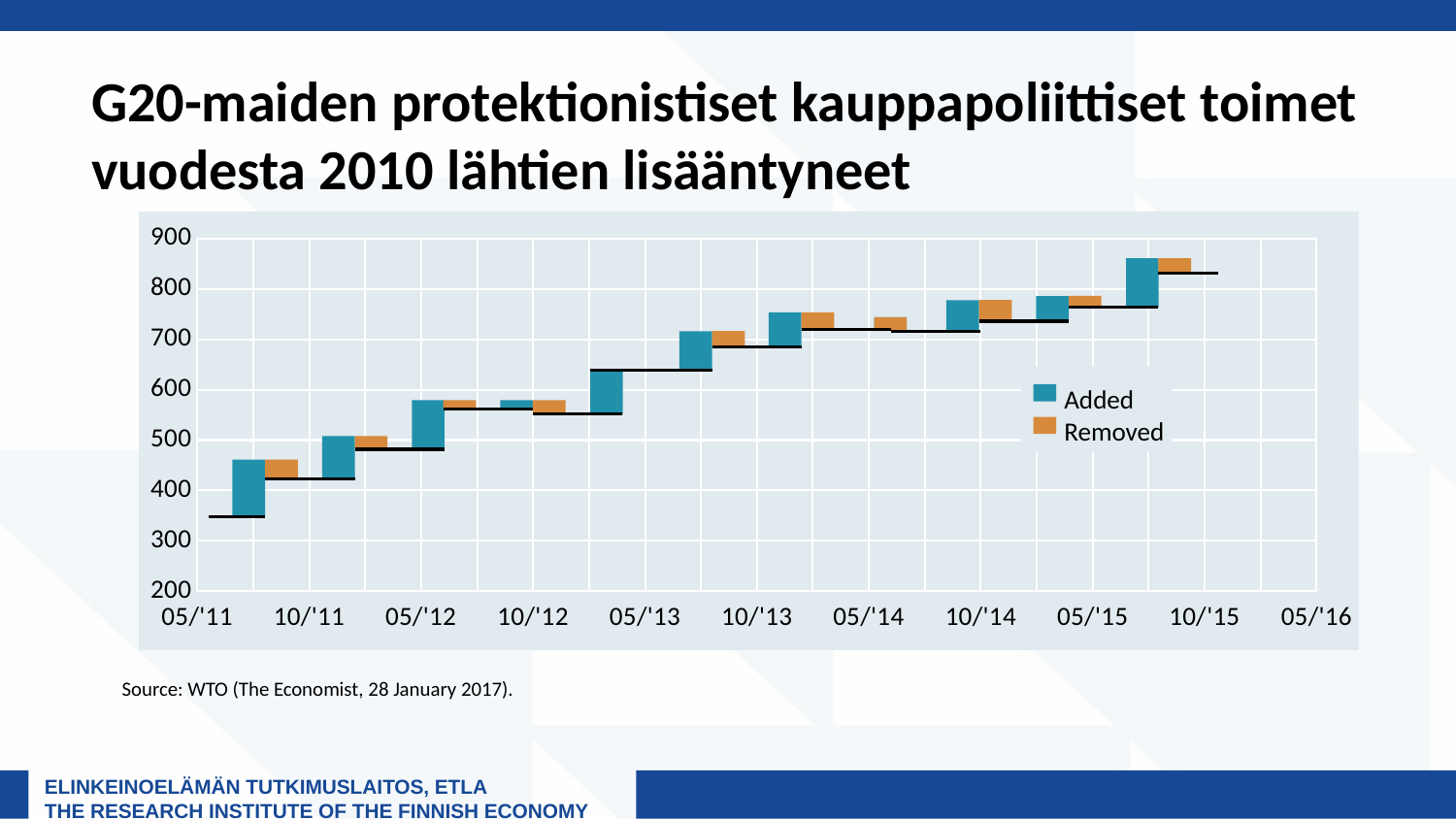
Do the cumulative levels rise or fall from 05/'11 to 10/'15? rise What kind of chart is shown on the slide? bar chart Is the level at 10/'12 greater or less than 500? greater What are the two series named in the legend? Added and Removed Is the final level reached at 10/'15 greater or less than 800? greater How many series does the legend list? 2 What is the highest value shown on the y axis? 900 Is the level at 05/'12 greater or less than 500? less How many date labels are shown on the x axis? 11 Which colour represents the 'Removed' series? orange